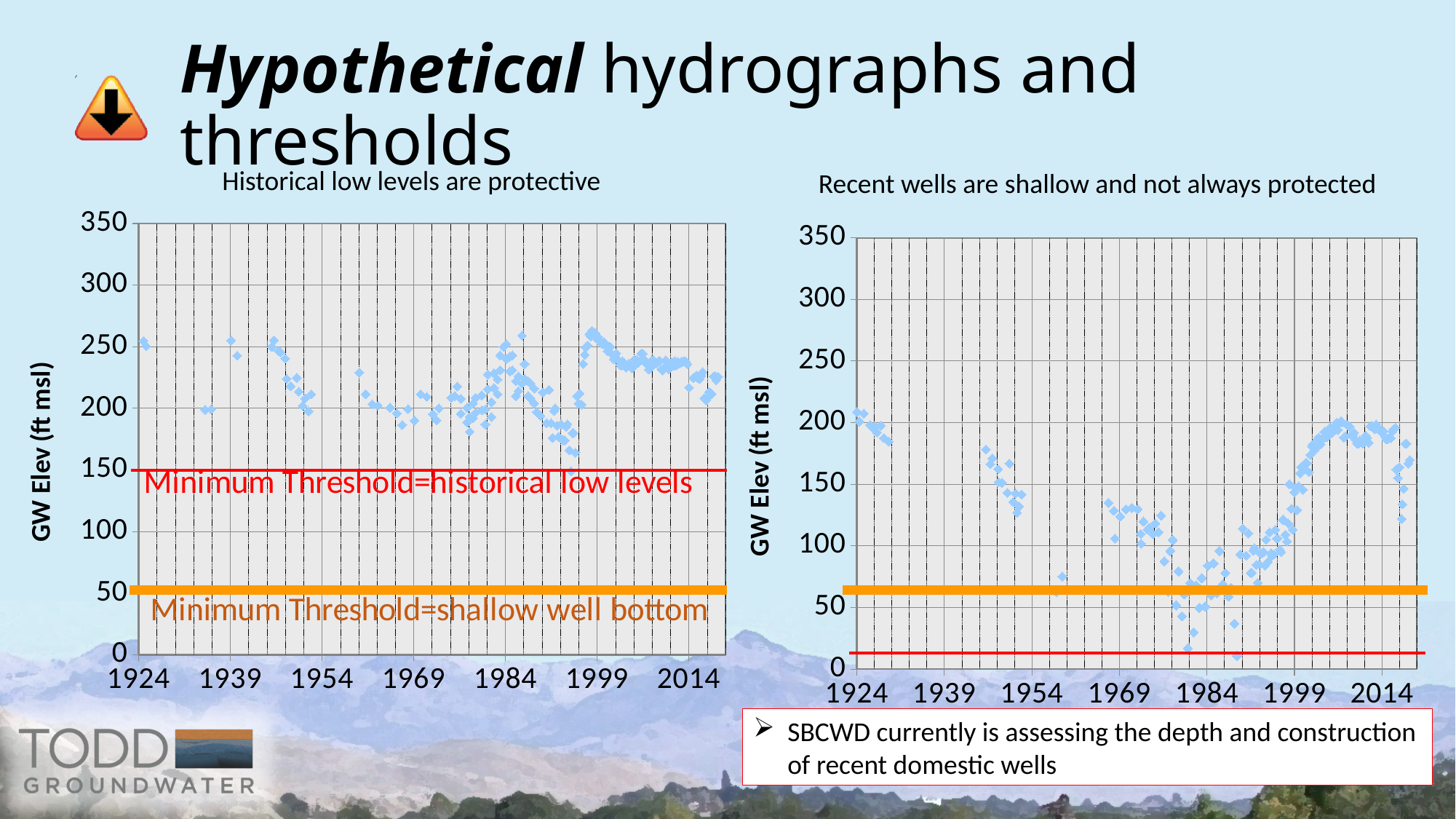
On the left chart, is the groundwater elevation around 2014 greater or less than 200? greater What is the y-axis label on the right chart titled 'Recent wells are shallow and not always protected'? GW Elev (ft msl) On the right chart, do groundwater elevations generally rise or fall from about 1984 to about 2009? rise What kind of chart is the left chart titled 'Historical low levels are protective'? scatter chart On the right chart, do groundwater elevations generally rise or fall from 1924 to about 1984? fall On the right chart, is the groundwater elevation around 1984 greater or less than 100? less What is the highest value shown on the y-axis of the left chart? 350 On the right chart, do any plotted points fall below the orange threshold line? Yes What is the first year shown on the x-axis of the right chart? 1924 On the left chart, what does the red horizontal line represent? Minimum Threshold=historical low levels